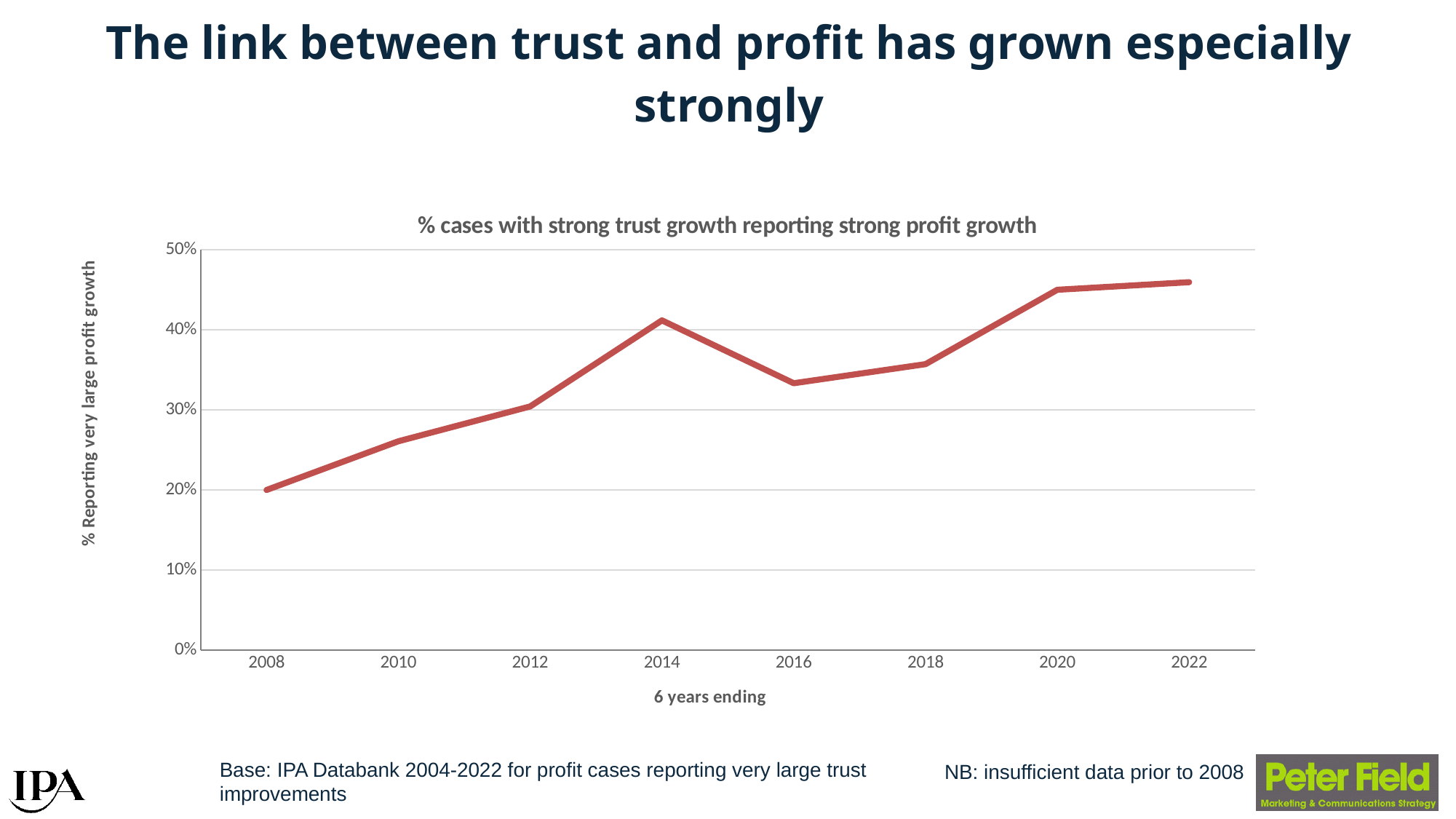
What kind of chart is shown on the slide? Line chart What is the value for 2008? 20% What is the label on the x axis of the chart? 6 years ending Which year has the lowest value on the chart? 2008 Is the value for 2018 greater or less than 40%? less Is the value for 2016 greater or less than 30%? greater How many data points are plotted on the line? 8 Is the value for 2020 greater or less than 40%? greater Which is larger, the value for 2014 or the value for 2016? 2014 Overall, do the values rise or fall from 2008 to 2022? Rise